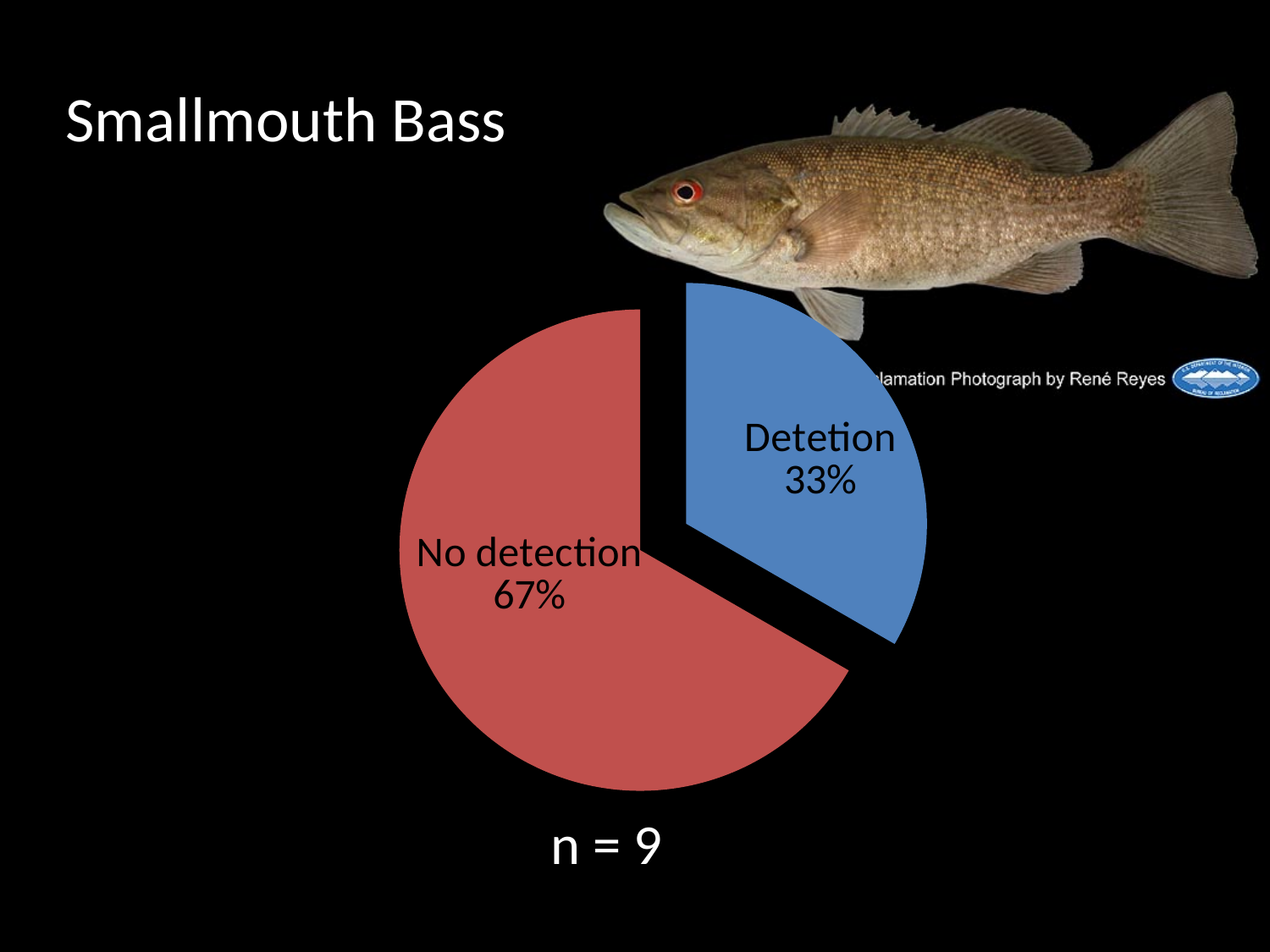
Which slice of the pie is the largest? No detection How many slices does the pie chart have? 2 What colour is the "No detection" slice of the pie? red Is the "Detetion" share of the pie greater or less than 50%? less Which slice of the pie is the smallest? Detetion Which is larger, the "Detetion" slice or the "No detection" slice? No detection What is the difference in percentage points between the "No detection" slice and the "Detetion" slice? 34 What percentage of the pie is labelled "Detetion"? 33% What percentage of the pie is labelled "No detection"? 67% What sample size is stated below the pie chart? n = 9 What kind of chart is shown on the slide? pie chart